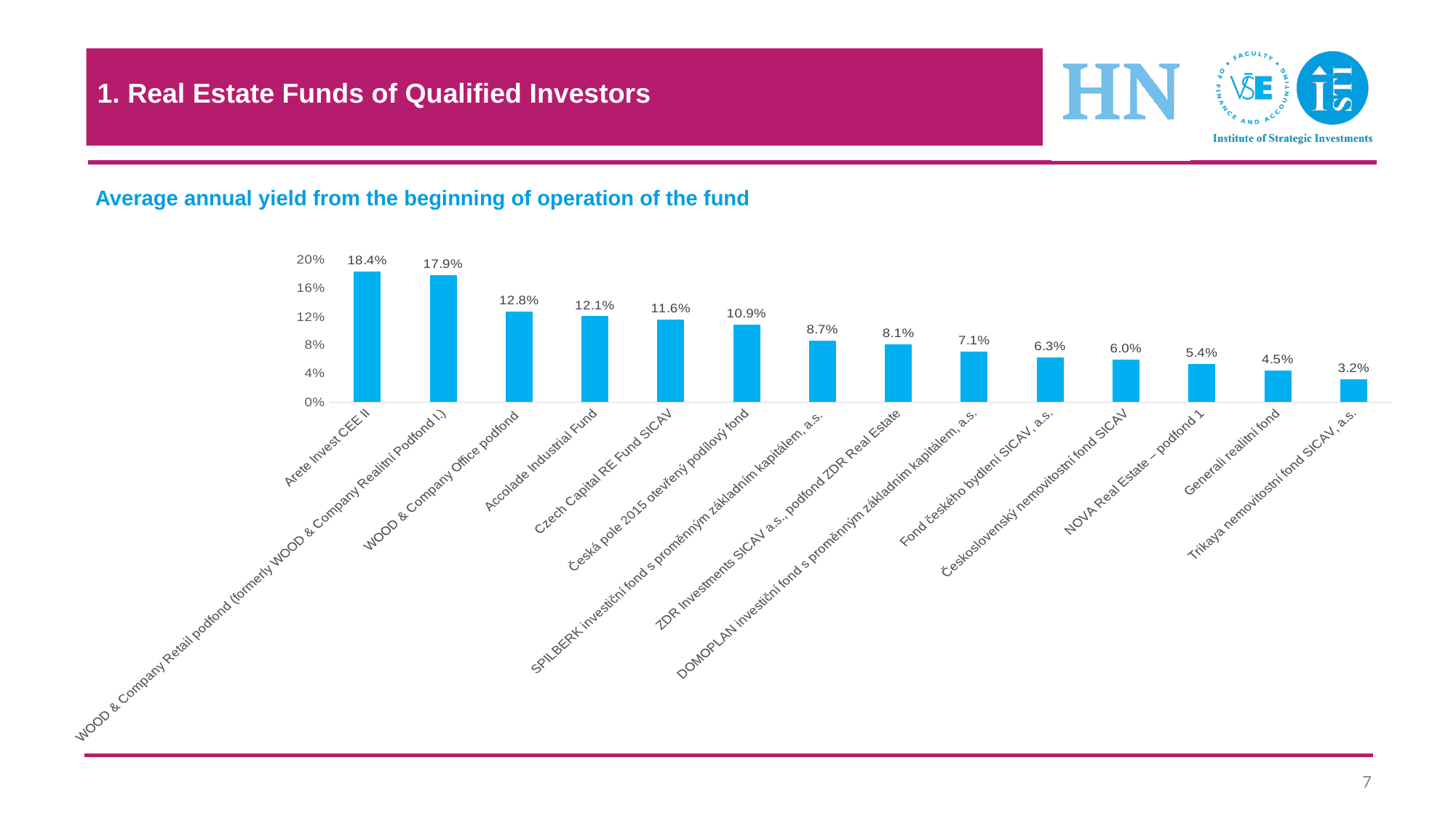
Is the value for Česká pole 2015 otevřený podílový fond greater or less than 8%? greater What is the value shown for Czech Capital RE Fund SICAV? 11.6% How many funds are shown in the chart? 14 Which has a higher value: Fond českého bydlení SICAV, a.s. or NOVA Real Estate – podfond 1? Fond českého bydlení SICAV, a.s. What type of chart is shown on the slide? Bar chart Which fund has the lowest average annual yield in the chart? Trikaya nemovitostní fond SICAV, a.s. What is the value shown for Generali realitní fond? 4.5% Do the values rise or fall from left to right along the x axis? Fall Which fund has the highest average annual yield in the chart? Arete Invest CEE II What is the value shown for Accolade Industrial Fund? 12.1% What is the average annual yield shown for Arete Invest CEE II? 18.4% What is the difference between the values for WOOD & Company Office podfond and Accolade Industrial Fund? 0.7%